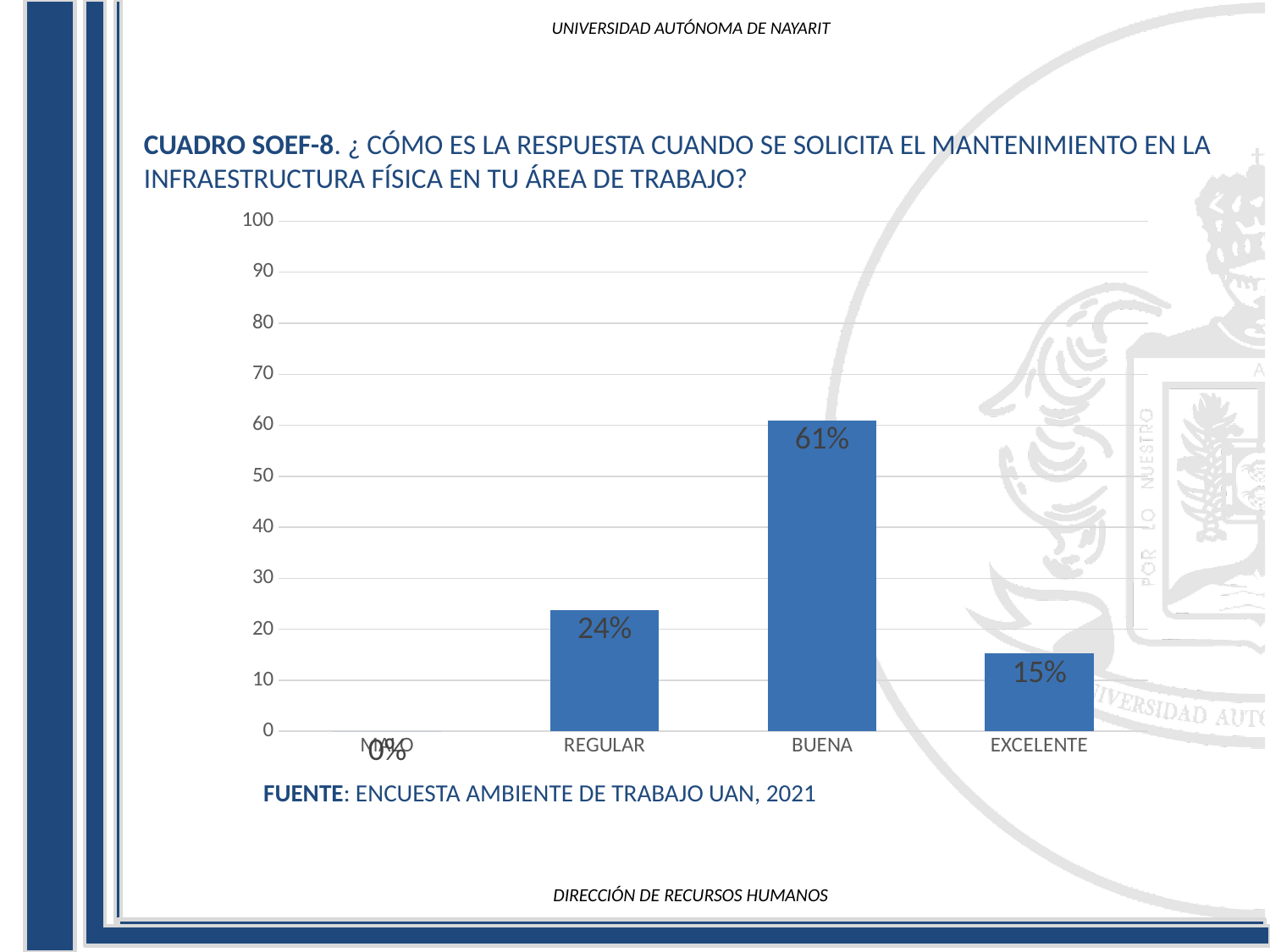
What kind of chart is shown on the slide? bar chart What is the difference between the values for BUENA and REGULAR? 37% Which is larger, the value for REGULAR or the value for EXCELENTE? REGULAR What is the value for EXCELENTE? 15% Which category has the highest value? BUENA What is the value for REGULAR? 24% What source is cited below the chart? ENCUESTA AMBIENTE DE TRABAJO UAN, 2021 Is the value for EXCELENTE greater or less than 20? less What is the difference between the values for REGULAR and EXCELENTE? 9% Is the value for BUENA greater or less than 50? greater How many categories are shown on the x axis? 4 What is the value for BUENA? 61%